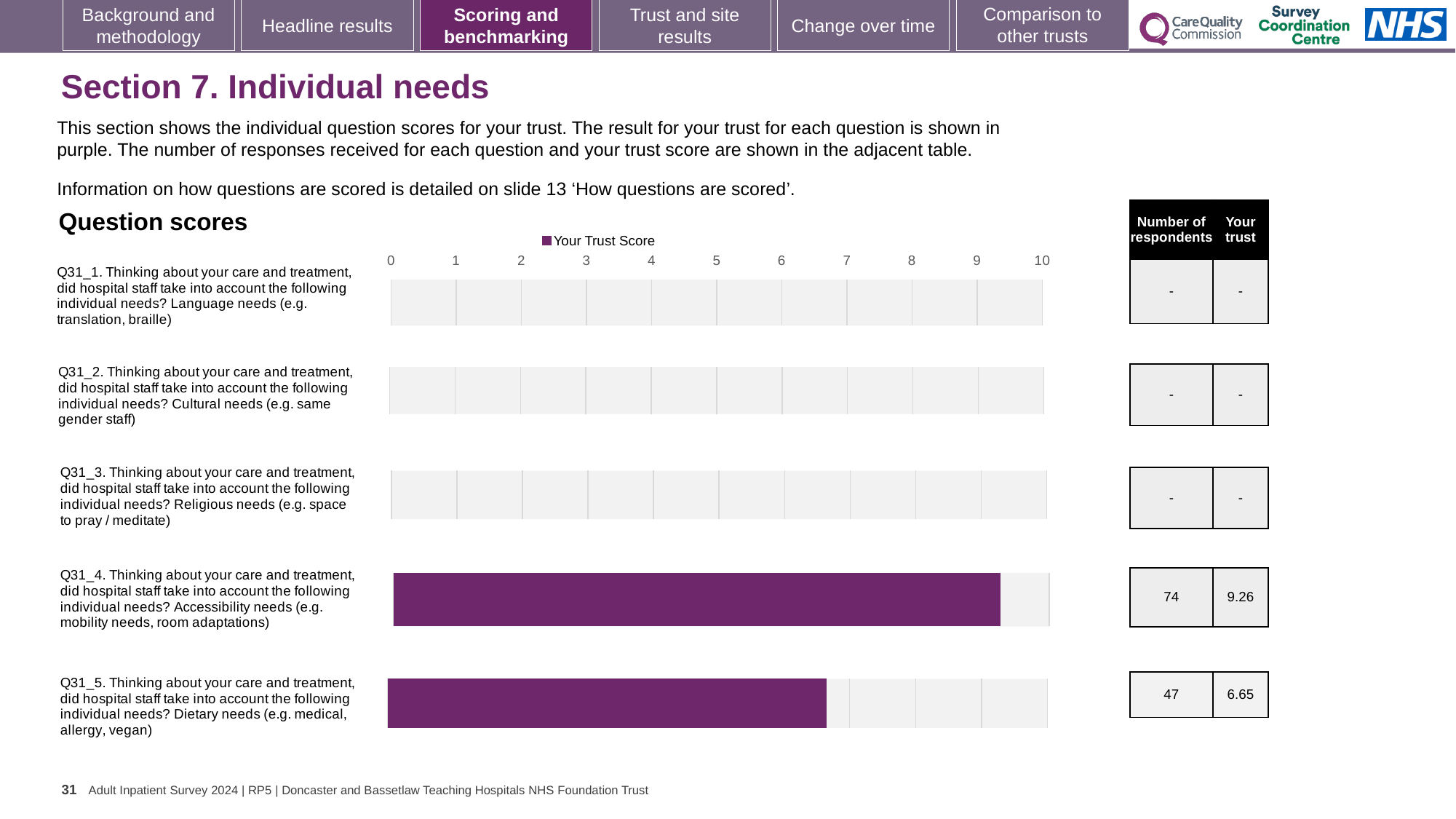
How many respondents answered Q31_5 (dietary needs)? 47 How many questions in the Question scores chart have no trust score shown (marked with a dash)? 3 Is the trust score for Q31_5 (dietary needs) greater or less than 7? less What is the difference between the trust scores for Q31_4 (accessibility needs) and Q31_5 (dietary needs)? 2.61 What is the trust score for Q31_4 (accessibility needs)? 9.26 What is the trust score for Q31_5 (dietary needs)? 6.65 What series name is shown in the chart legend? Your Trust Score How many respondents answered Q31_4 (accessibility needs)? 74 Is the trust score for Q31_4 (accessibility needs) greater or less than 9? greater Which question has the higher trust score, Q31_4 (accessibility needs) or Q31_5 (dietary needs)? Q31_4 How many questions are listed in the Question scores chart? 5 What type of chart is used to show the question scores? Bar chart